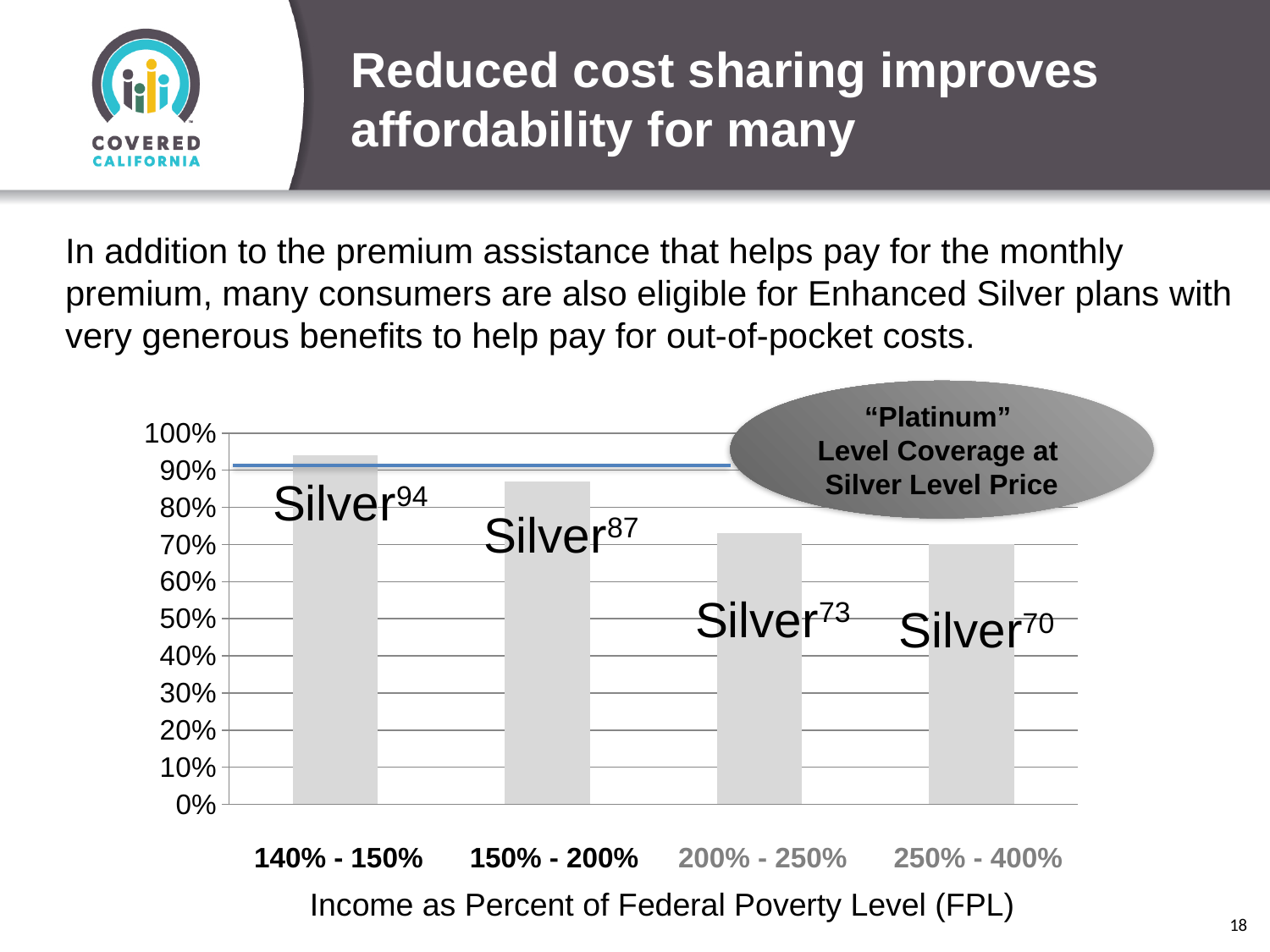
Is the bar for 200% - 250% greater or less than 80%? less Is the bar for 140% - 150% greater or less than 90%? greater Is the bar for 150% - 200% greater or less than 90%? less Which income category has the shortest bar in the chart? 250% - 400% What kind of chart is shown on the slide? bar chart How many income categories are shown on the x axis of the chart? 4 What plan label is shown on the bar for the 140% - 150% income category? Silver94 Which bar is taller, 150% - 200% or 200% - 250%? 150% - 200% Which income category has the tallest bar in the chart? 140% - 150% Do the bar values rise or fall as income moves from 140% - 150% to 250% - 400%? fall What is the title of the x axis of the chart? Income as Percent of Federal Poverty Level (FPL)